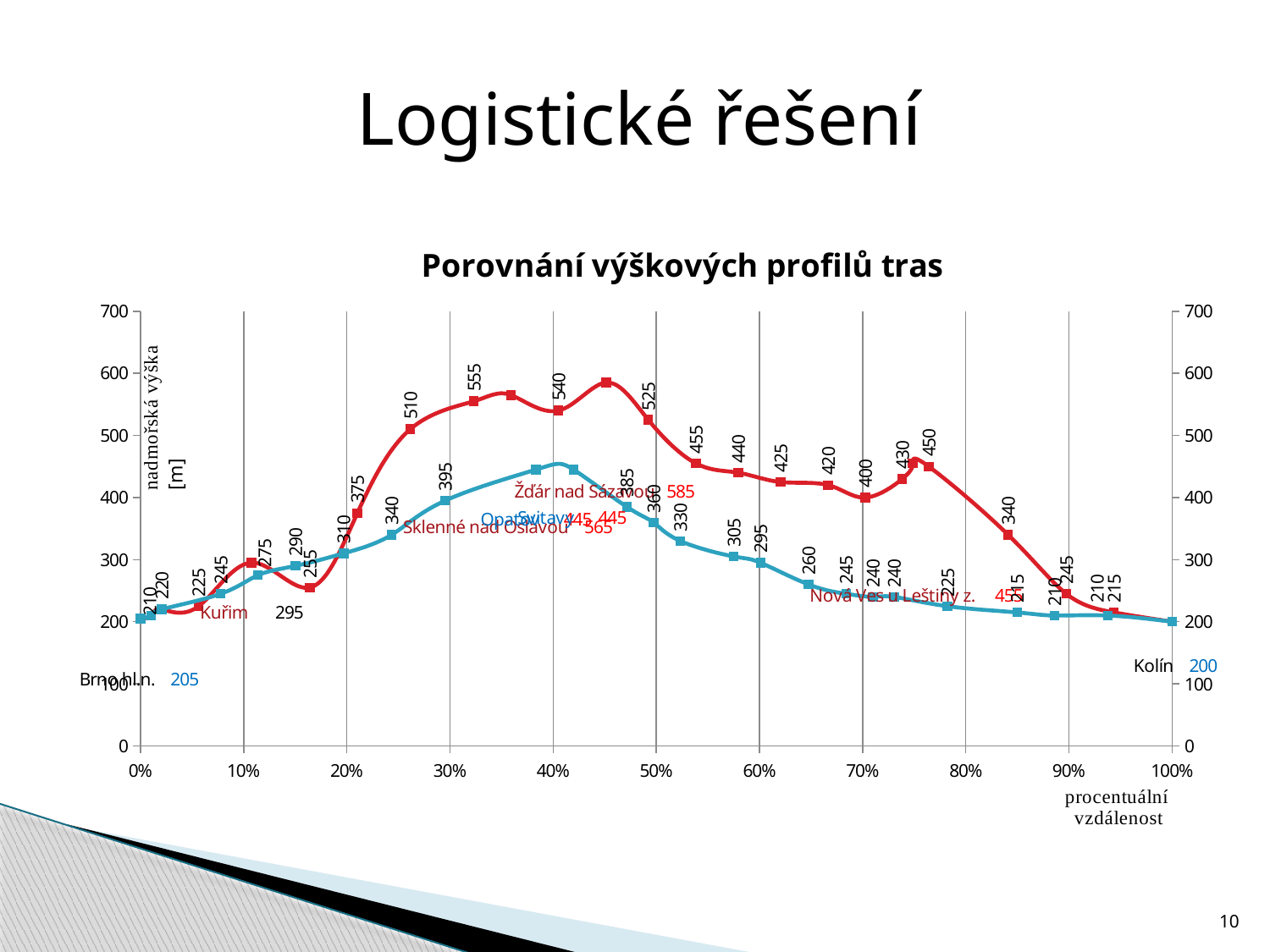
What elevation is printed for Kolín at the end of the route? 200 What elevation is printed for Žďár nad Sázavou on the red line? 585 What is the label of the vertical axis of the chart? nadmořská výška [m] Is the value of the red line at 30% greater or less than 500? greater Is the value of the blue line at 40% greater or less than 400? greater What kind of chart is shown on the slide? line chart What is the title of the chart? Porovnání výškových profilů tras What is the highest value reached by the red line? 585 What elevation is printed for Brno hl.n. at the start of the route? 205 At 60% of the distance, which line is higher, the red or the blue? red Do the lines rise or fall between 80% and 100% of the distance? fall How many tick marks are labelled on the horizontal axis? 11